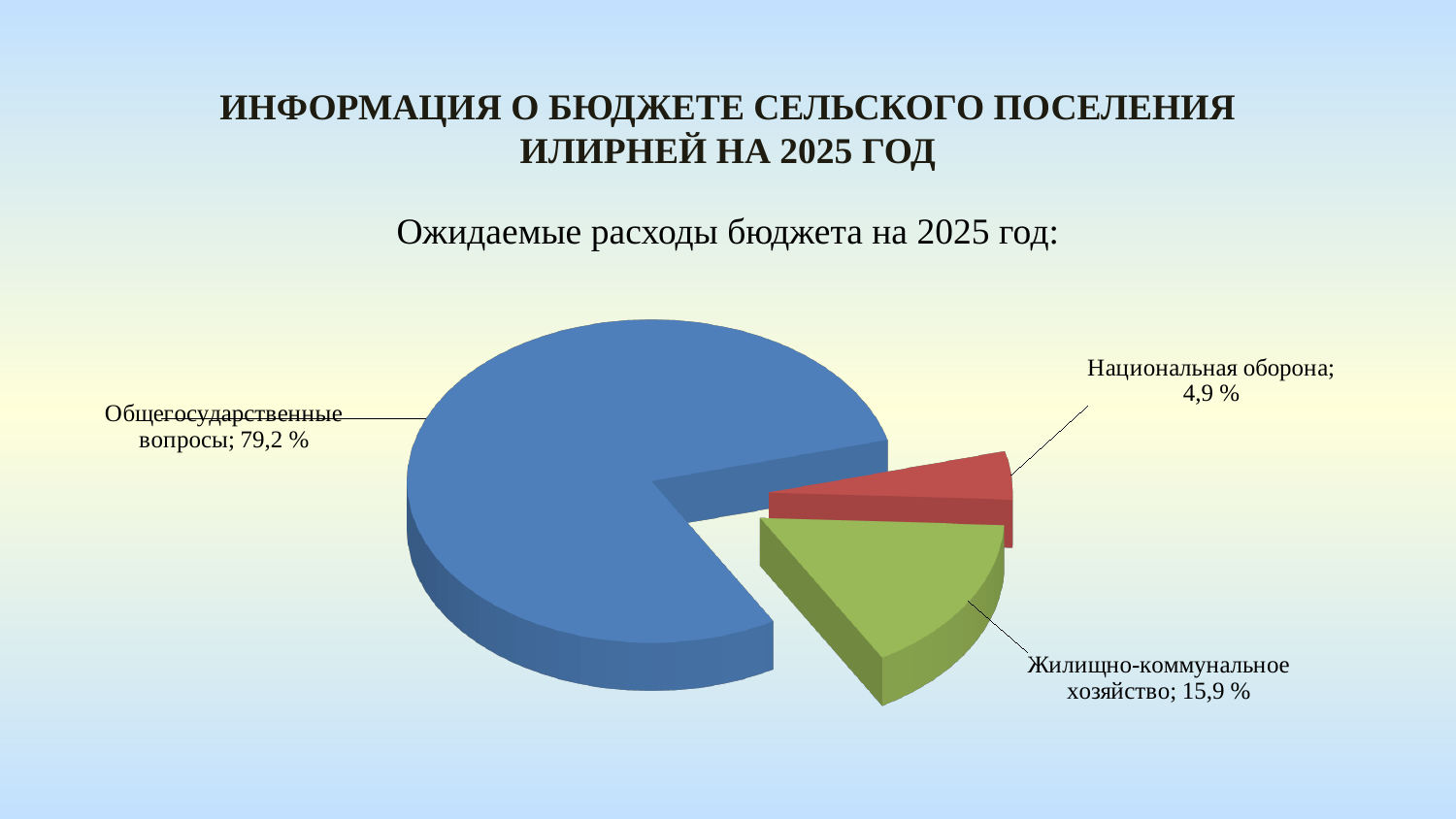
What is the subtitle above the chart? Ожидаемые расходы бюджета на 2025 год: What is the difference in percentage points between Общегосударственные вопросы and Жилищно-коммунальное хозяйство? 63,3 Which category has the largest slice of the pie? Общегосударственные вопросы What share of the pie does Жилищно-коммунальное хозяйство have? 15,9 % What kind of chart is shown on the slide? Pie chart Which is larger, the share for Жилищно-коммунальное хозяйство or for Национальная оборона? Жилищно-коммунальное хозяйство How many slices does the pie chart have? 3 What share of the pie does Национальная оборона have? 4,9 % Which category has the smallest slice of the pie? Национальная оборона What is the difference in percentage points between Жилищно-коммунальное хозяйство and Национальная оборона? 11 What colour is the slice for Национальная оборона? Red What share of the pie does Общегосударственные вопросы have? 79,2 %